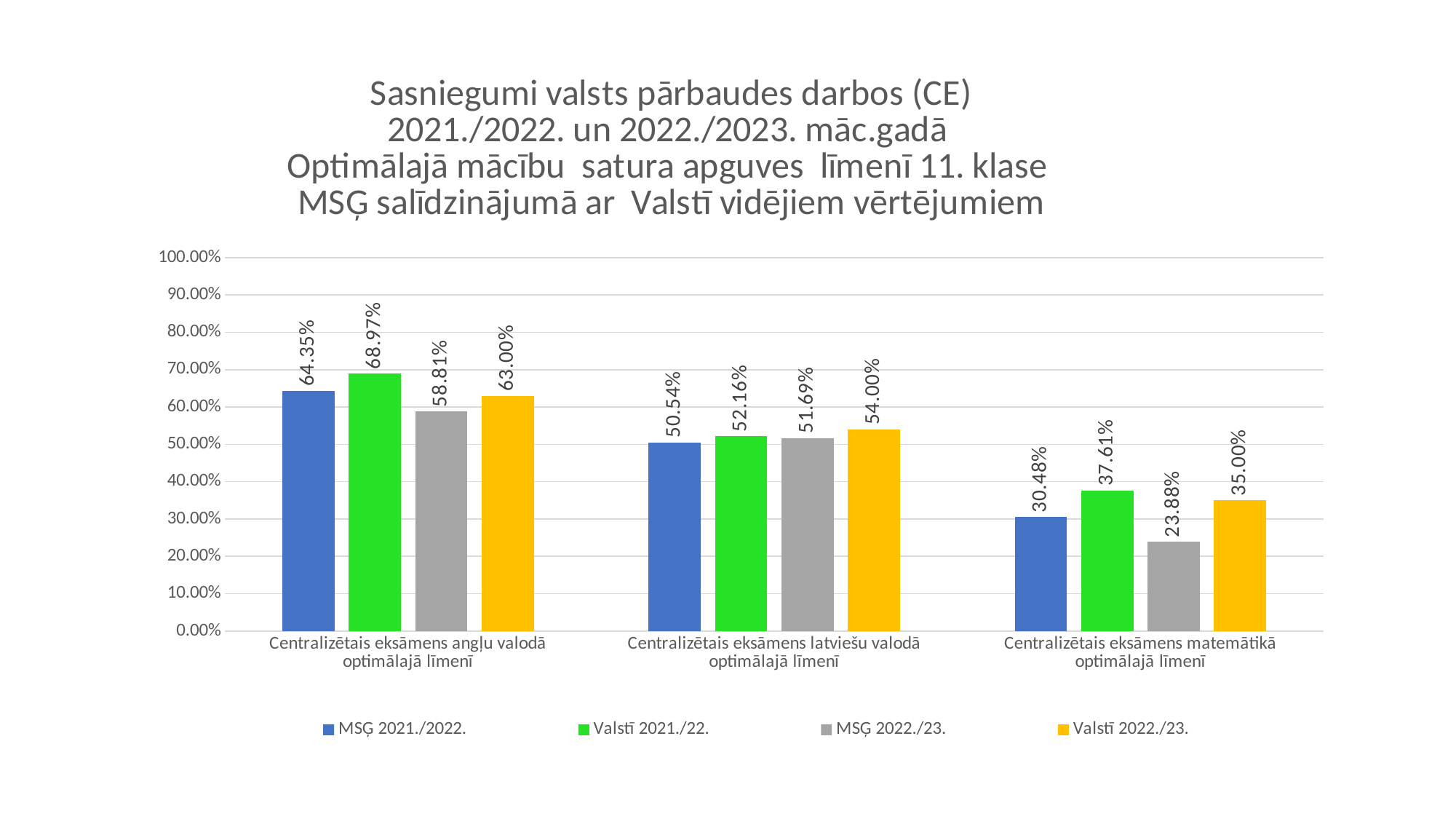
How many categories are shown on the x axis of the chart? 3 Which series has the lowest value in the category 'Centralizētais eksāmens matemātikā optimālajā līmenī'? MSĢ 2022./23. What is the difference between Valstī 2022./23. and MSĢ 2022./23. in the category 'Centralizētais eksāmens angļu valodā optimālajā līmenī'? 4.19% What is the value for MSĢ 2022./23. in the category 'Centralizētais eksāmens latviešu valodā optimālajā līmenī'? 51.69% What is the value for Valstī 2022./23. in the category 'Centralizētais eksāmens matemātikā optimālajā līmenī'? 35.00% Which series has the highest value in the category 'Centralizētais eksāmens angļu valodā optimālajā līmenī'? Valstī 2021./22. What kind of chart is shown on the slide? bar chart What is the difference between Valstī 2021./22. and MSĢ 2021./2022. in the category 'Centralizētais eksāmens matemātikā optimālajā līmenī'? 7.13% How many series does the legend list? 4 What is the value for MSĢ 2021./2022. in the category 'Centralizētais eksāmens angļu valodā optimālajā līmenī'? 64.35% Which is larger in the category 'Centralizētais eksāmens latviešu valodā optimālajā līmenī': MSĢ 2021./2022. or Valstī 2022./23.? Valstī 2022./23. Is the value for MSĢ 2022./23. in the category 'Centralizētais eksāmens matemātikā optimālajā līmenī' greater or less than 30.00%? less